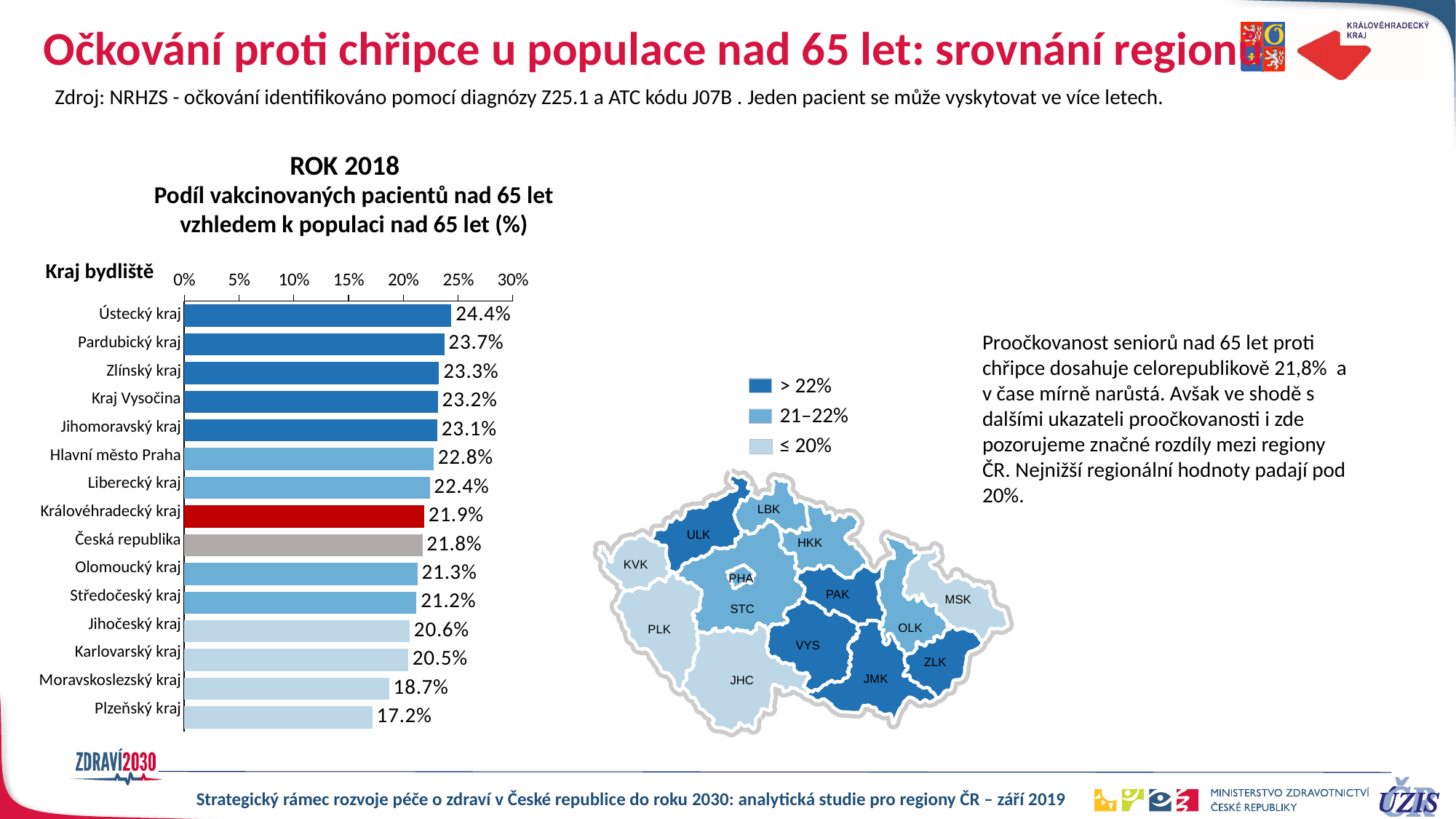
What is the value for Ústecký kraj in the bar chart? 24.4% What is the value for Královéhradecký kraj in the bar chart? 21.9% Which region has the lowest value in the bar chart? Plzeňský kraj Which has a larger value, Pardubický kraj or Zlínský kraj? Pardubický kraj What is the difference between the values for Ústecký kraj and Plzeňský kraj? 7.2 percentage points What is the value for Moravskoslezský kraj in the bar chart? 18.7% How many bars are shown in the bar chart? 15 What kind of chart is used to show the share of vaccinated patients over 65 by region? bar chart Is the value for Karlovarský kraj greater or less than 25%? less Which region has the highest value in the bar chart? Ústecký kraj Which bar in the chart is coloured red? Královéhradecký kraj What is the value shown for Česká republika in the bar chart? 21.8%